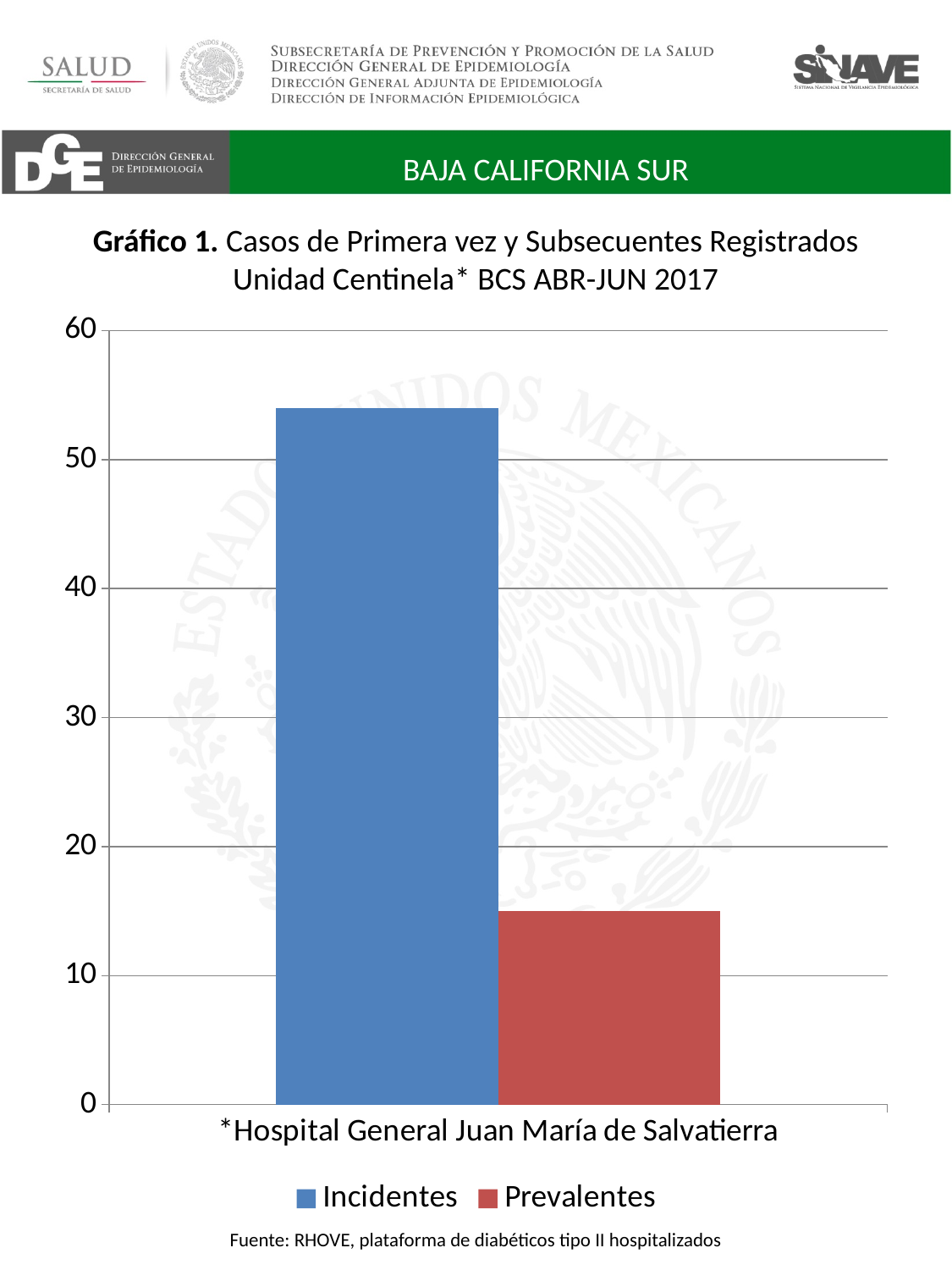
Which series has the lowest bar? Prevalentes Is the value for Incidentes greater or less than 50? greater What colour is the bar for Prevalentes? red How many categories are shown on the x axis? 1 Is the value for Prevalentes greater or less than 10? greater What is the category label on the x axis? *Hospital General Juan María de Salvatierra What kind of chart is shown on the slide? bar chart Is the value for Prevalentes greater or less than 20? less How many series does the legend list? 2 What is the highest value shown on the y axis? 60 Which series has the higher value, Incidentes or Prevalentes? Incidentes